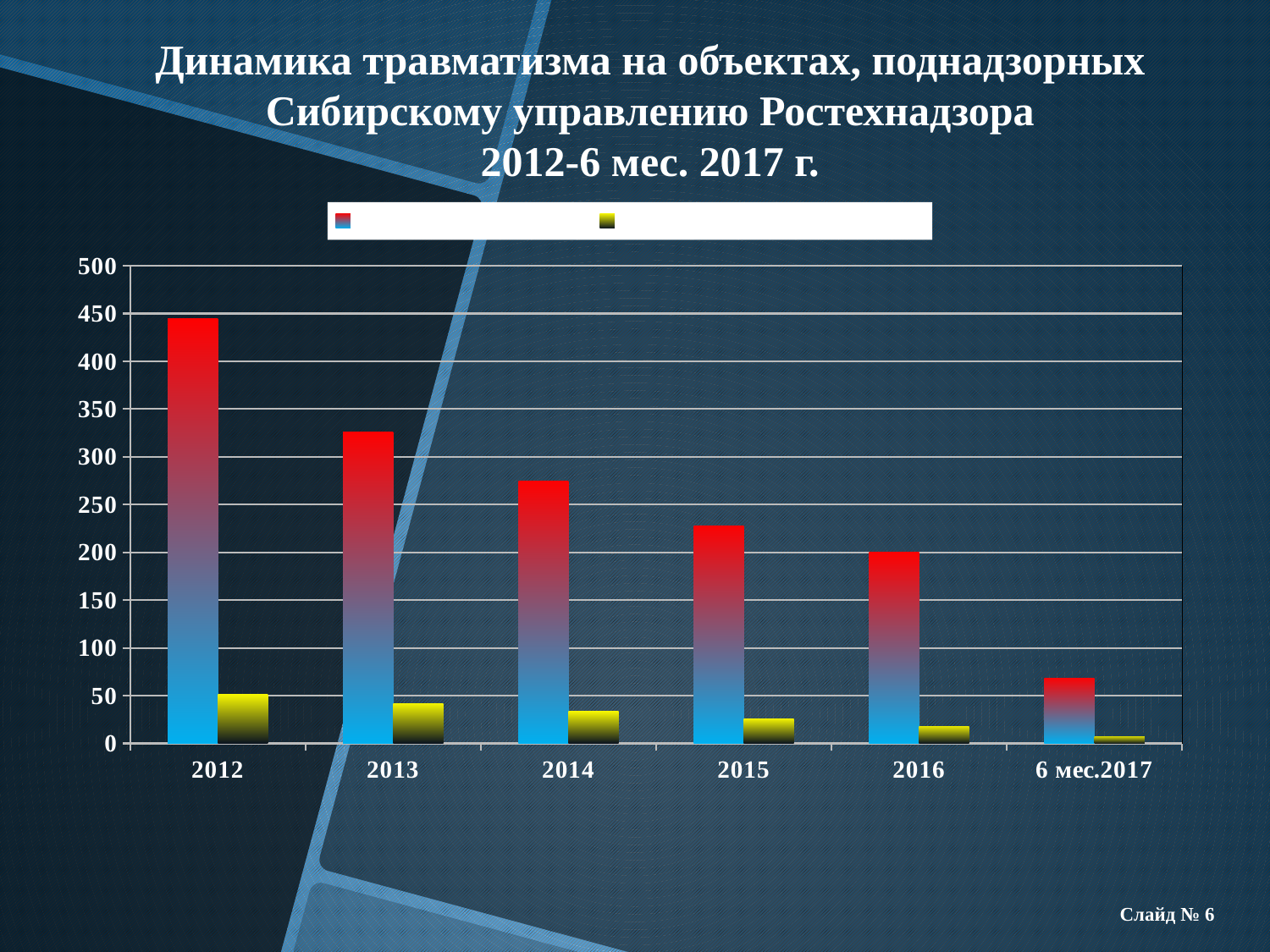
Which is larger for the red series: the value for 2013 or the value for 2015? 2013 Which category has the highest value for the red series? 2012 Is the value of the red series for 2014 greater or less than 250? greater Which category has the lowest value for the yellow series? 6 мес.2017 Is the value of the yellow series for 2016 greater or less than 50? less Is the value of the red series for 2012 greater or less than 400? greater Do the values of the red series rise or fall from 2012 to 6 мес.2017? fall What kind of chart is shown on the slide? bar chart Which category has the lowest value for the red series? 6 мес.2017 How many series does the legend list? 2 How many categories are shown along the x axis? 6